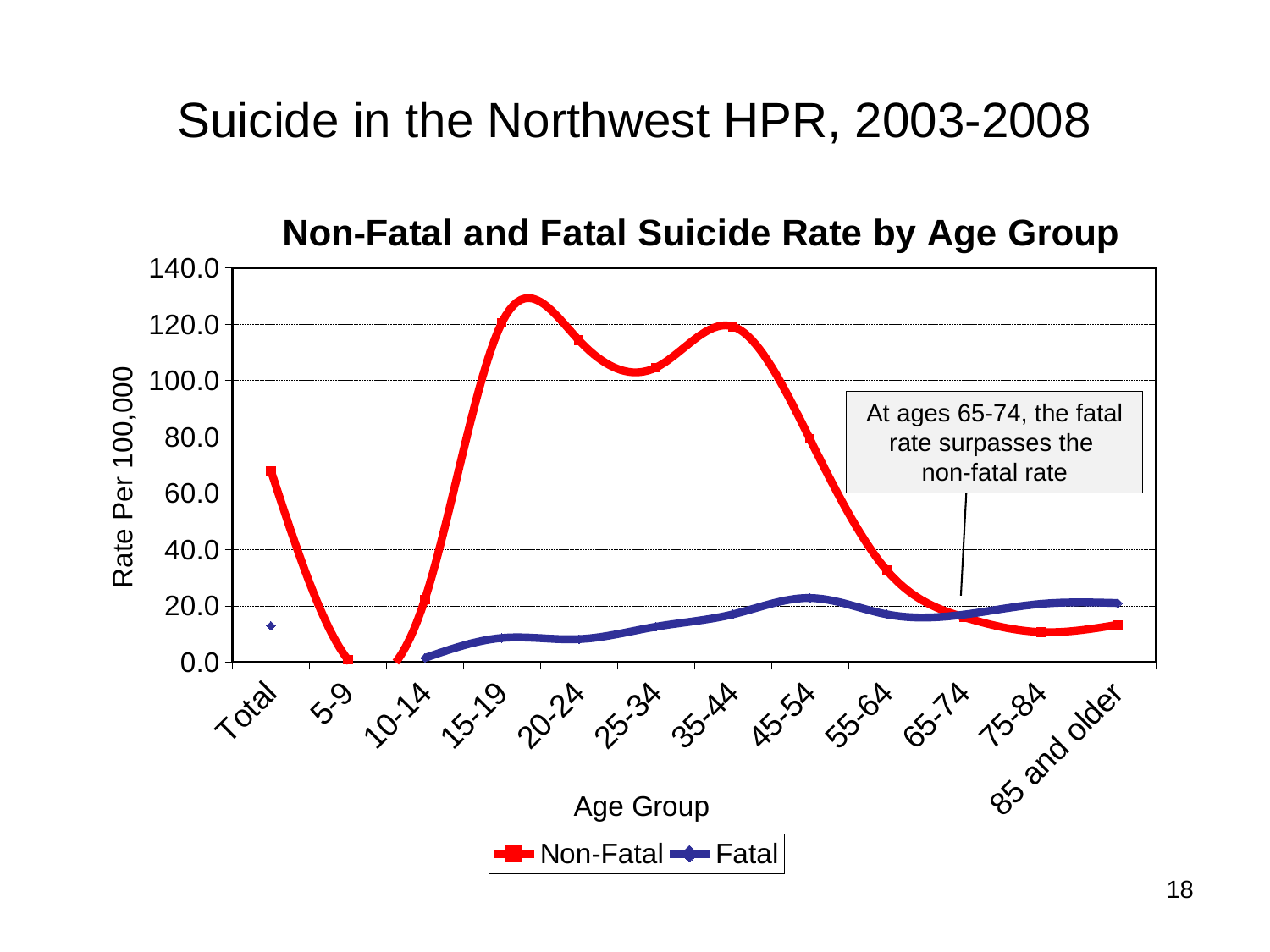
Is the Fatal value for the 15-19 age group greater or less than 20? less Is the Non-Fatal value for Total greater or less than 60? greater Is the Non-Fatal value for the 20-24 age group greater or less than 100? greater How many series does the legend list? 2 How many age-group categories are shown on the x axis? 12 What kind of chart is shown on the slide? Line chart Does the Non-Fatal rate rise or fall from the 45-54 age group to the 75-84 age group? Fall According to the annotation on the chart, at which age group does the fatal rate surpass the non-fatal rate? 65-74 Which series has the larger value at the 75-84 age group, Non-Fatal or Fatal? Fatal Which series has the larger value at the 15-19 age group, Non-Fatal or Fatal? Non-Fatal Which age group has the lowest Fatal rate? 10-14